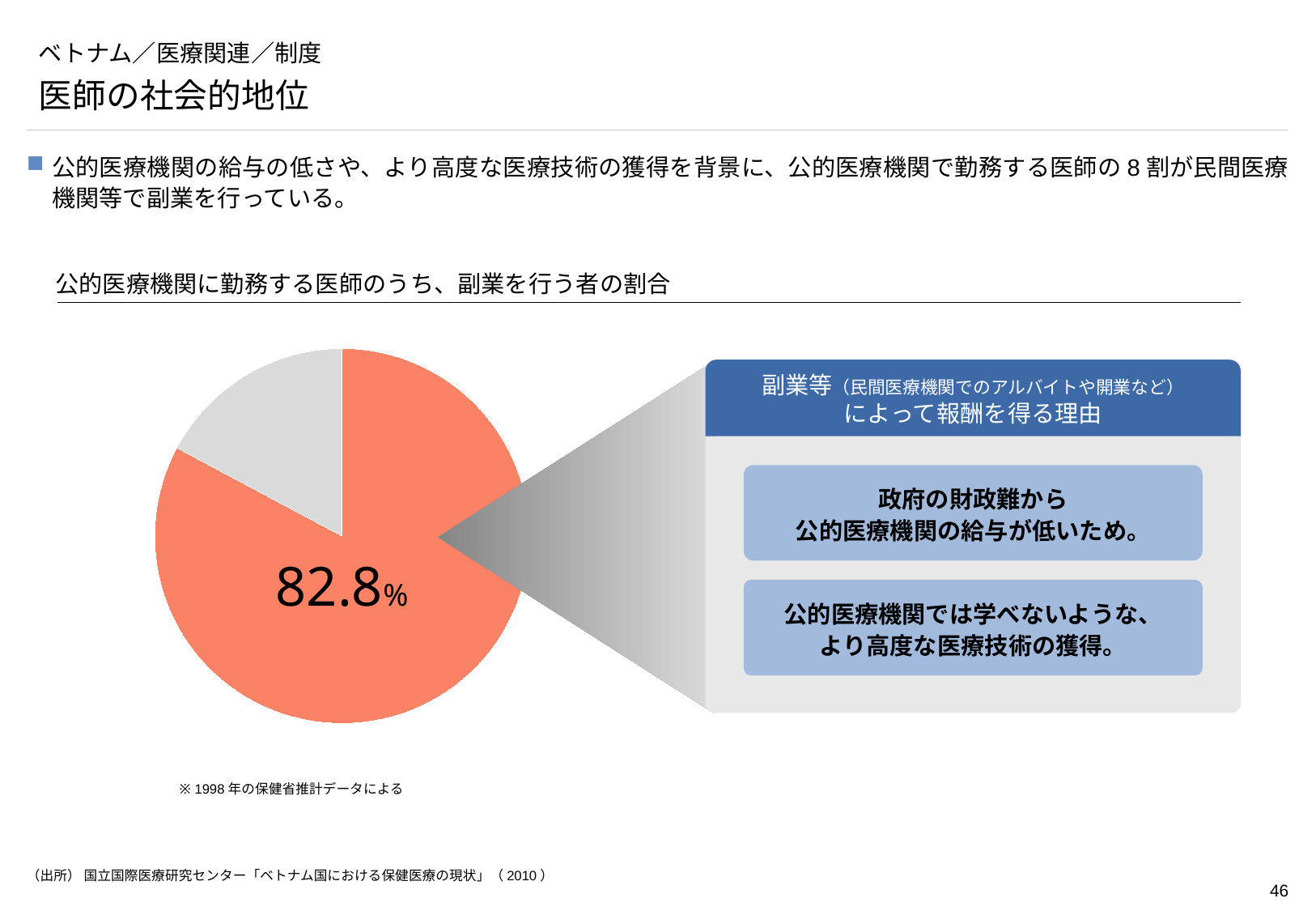
What is the title of the pie chart? 公的医療機関に勤務する医師のうち、副業を行う者の割合 How many slices does the pie chart have? 2 Which slice is the largest in the pie chart? The orange slice (82.8%) What percentage is printed on the pie chart? 82.8% What colour is the slice labelled 82.8%? Orange What share of the pie does the orange slice represent? 82.8% Which slice of the pie chart is larger, the orange one or the grey one? The orange one What kind of chart is shown on the slide? Pie chart